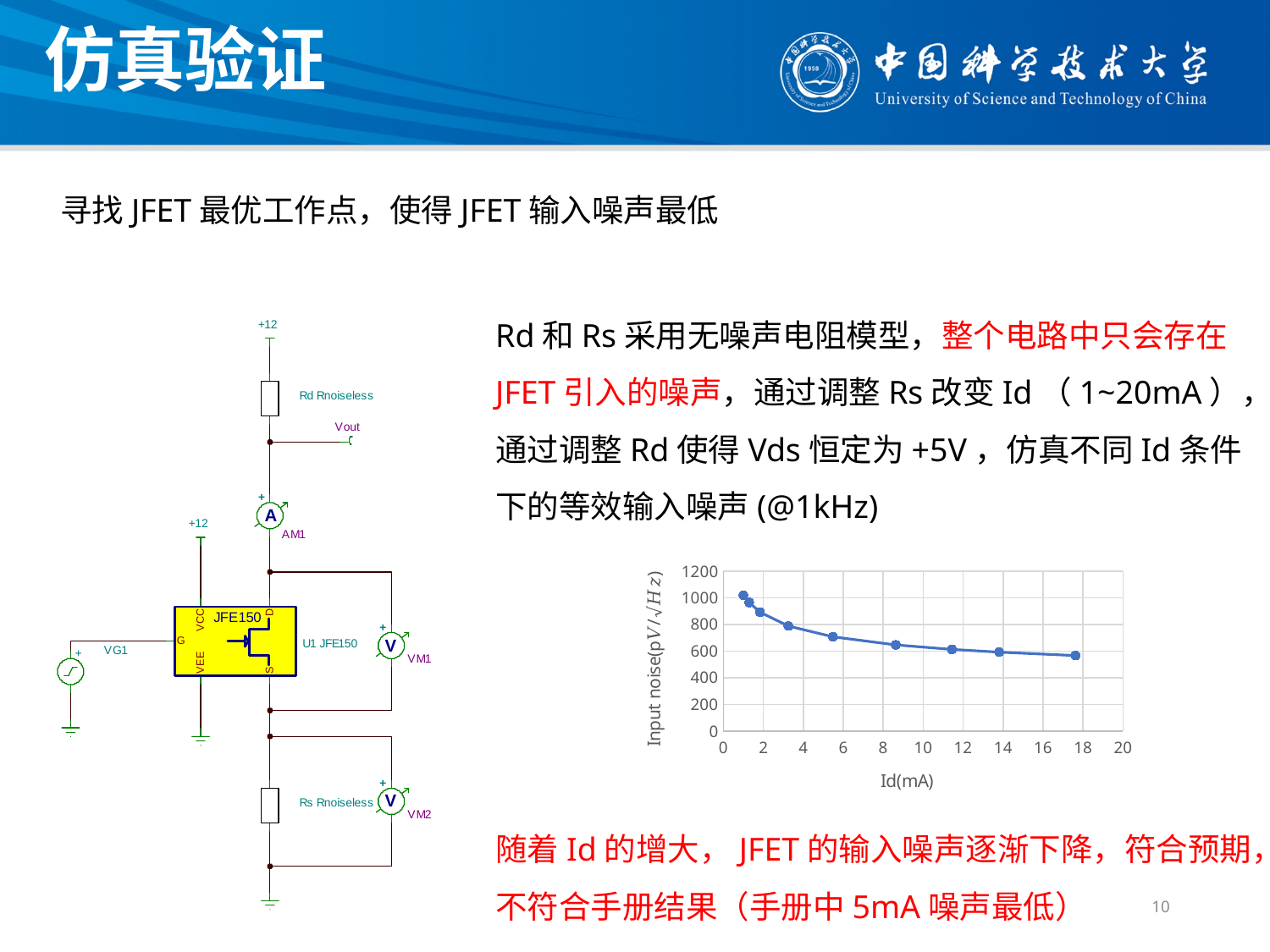
Which has the larger input noise: the point at Id of about 3 mA or the point at Id of about 14 mA? the point at about 3 mA At which end of the Id range is the input noise highest, the low end or the high end? the low end Is the input noise at the lowest plotted Id (around 1 mA) greater or less than 800? greater As Id increases along the x axis, does the input noise rise or fall? fall Is the input noise at Id of about 8 mA greater or less than 400? greater What is the maximum value shown on the y axis? 1200 What kind of chart is shown on the slide? line chart What is the title of the x axis of the chart? Id(mA) What is the title of the y axis of the chart? Input noise(pV/√Hz) Is the input noise at the highest plotted Id (around 18 mA) greater or less than 800? less